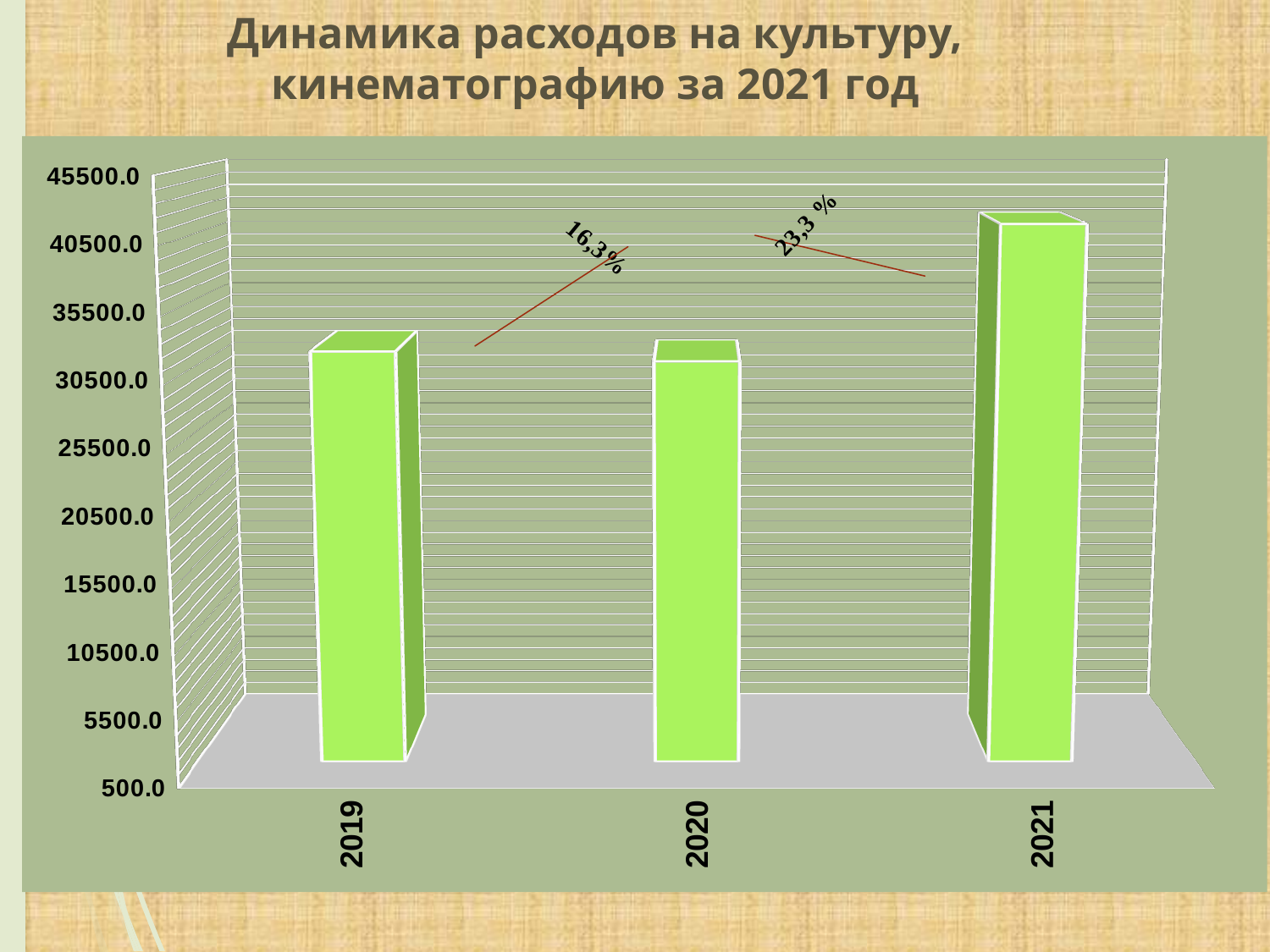
What kind of chart is shown on the slide? bar chart Which is larger, the value for 2020 or the value for 2021? 2021 Is the value for 2020 greater or less than 25500.0? greater Is the value for 2021 greater or less than 35500.0? greater Is the value for 2019 greater or less than 35500.0? less Which is larger, the value for 2021 or the value for 2019? 2021 What percentage annotation is written between the 2020 and 2021 bars? 23,3 % What is the title of the chart? Динамика расходов на культуру, кинематографию за 2021 год Which year has the highest value on the chart? 2021 How many years (categories) are plotted on the chart? 3